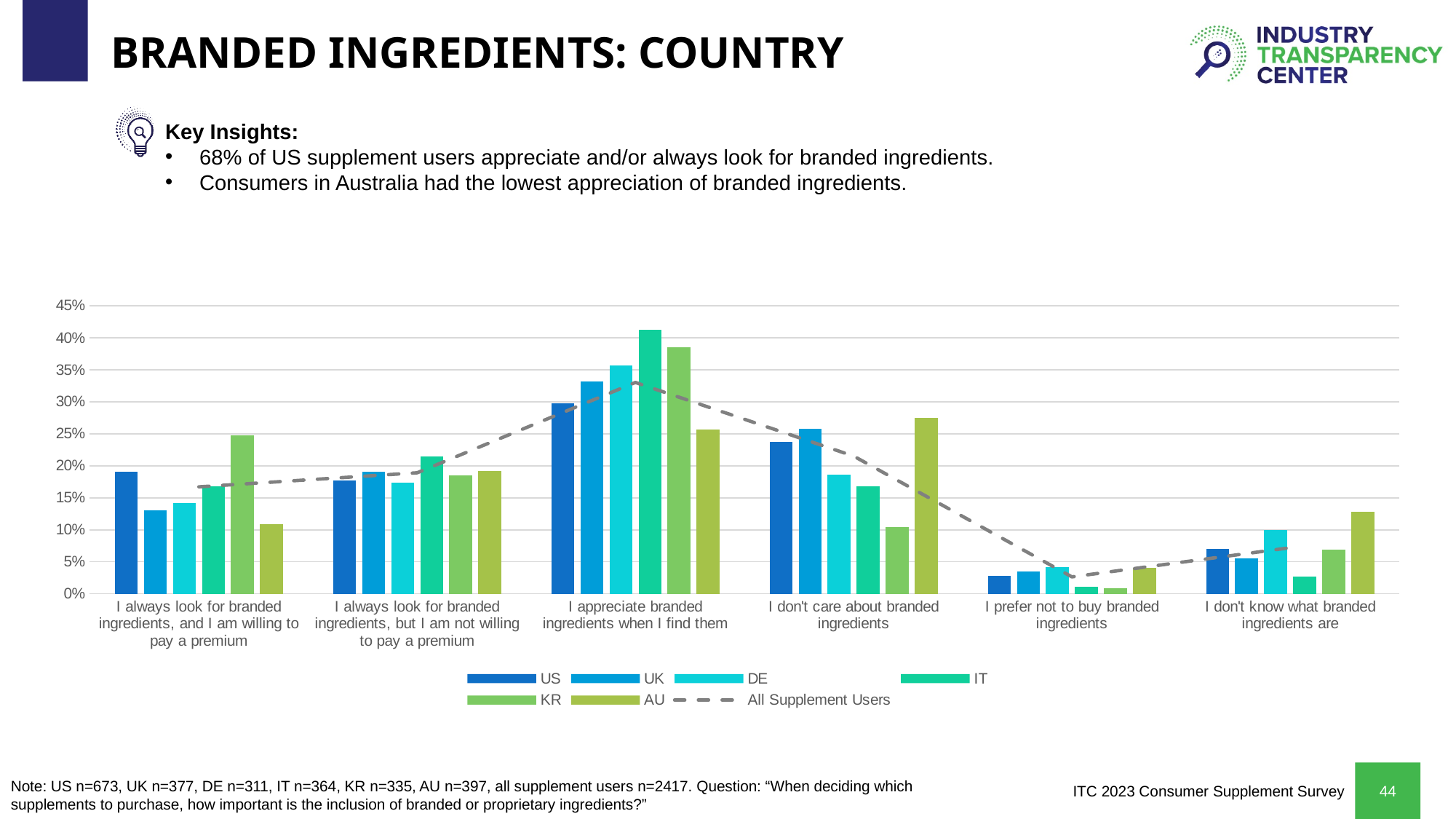
Is the IT value for "I appreciate branded ingredients when I find them" greater or less than 40%? greater Is the AU value for "I don't know what branded ingredients are" greater or less than 10%? greater What kind of chart is shown on the slide? combination bar and line chart Which country has the lowest value for "I appreciate branded ingredients when I find them"? AU How many response categories are shown along the x axis? 6 Which country has the highest value for "I always look for branded ingredients, and I am willing to pay a premium"? KR How many series does the legend list? 7 What is the name of the series plotted as a dashed line? All Supplement Users Is the KR value for "I don't care about branded ingredients" greater or less than 15%? less Which country has the lowest value for "I don't know what branded ingredients are"? IT Which country has the highest value for "I appreciate branded ingredients when I find them"? IT For "I don't care about branded ingredients", which is larger, the KR value or the AU value? AU